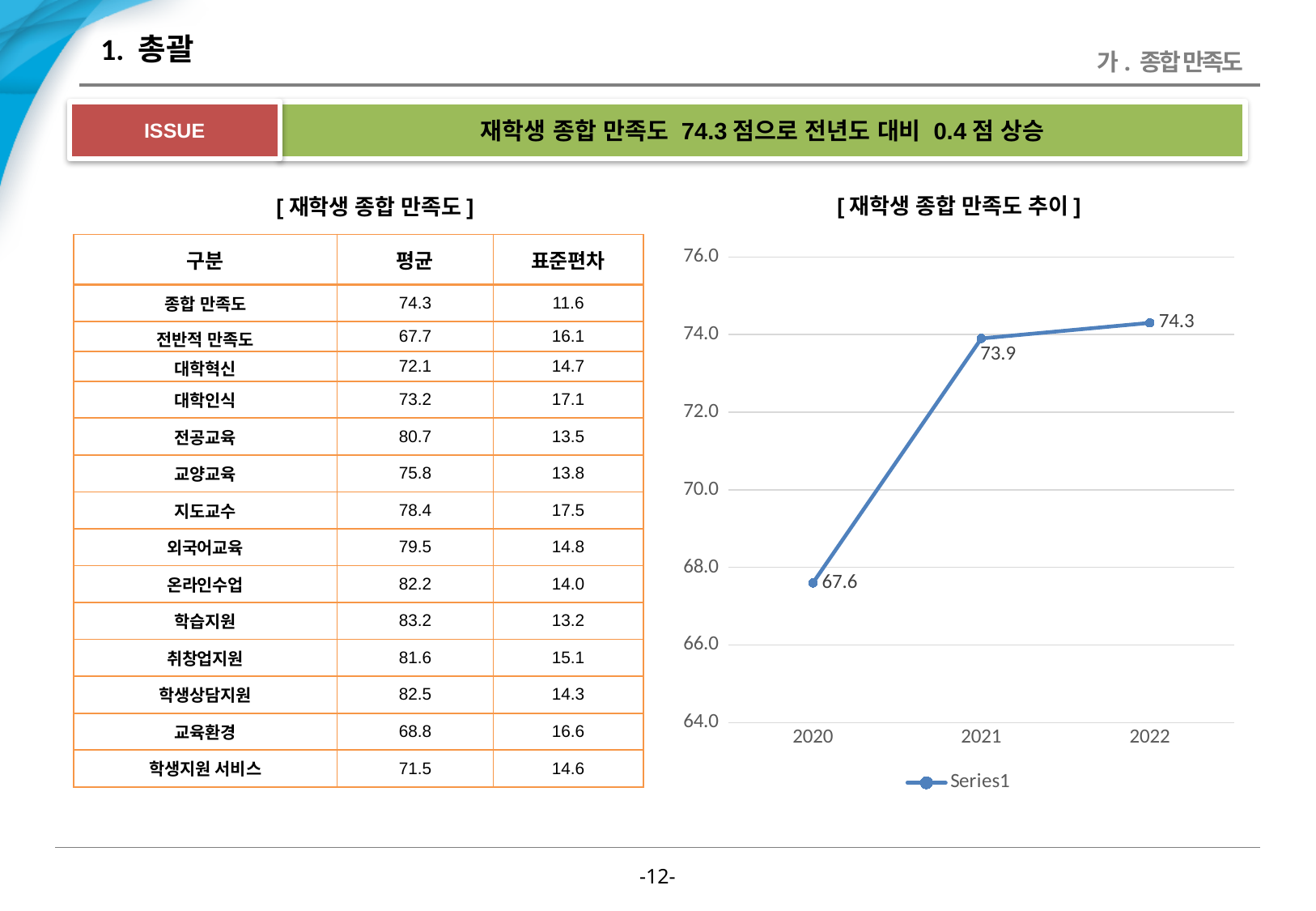
Do the values in the [ 재학생 종합 만족도 추이 ] chart rise or fall from 2020 to 2022? rise In the [ 재학생 종합 만족도 추이 ] chart, is the value for 2020 greater or less than 68.0? less What type of chart is shown under the title [ 재학생 종합 만족도 추이 ]? line chart In the [ 재학생 종합 만족도 추이 ] chart, which is larger, the value for 2020 or the value for 2021? 2021 In the [ 재학생 종합 만족도 추이 ] chart, what is the value for 2022? 74.3 In the [ 재학생 종합 만족도 추이 ] chart, which year has the lowest value? 2020 How many data points are plotted in the [ 재학생 종합 만족도 추이 ] chart? 3 In the [ 재학생 종합 만족도 추이 ] chart, what is the difference between the 2021 and 2020 values? 6.3 In the [ 재학생 종합 만족도 추이 ] chart, which year has the highest value? 2022 In the [ 재학생 종합 만족도 추이 ] chart, what is the value for 2020? 67.6 In the [ 재학생 종합 만족도 추이 ] chart, what is the value for 2021? 73.9 In the [ 재학생 종합 만족도 추이 ] chart, what is the difference between the 2022 and 2021 values? 0.4